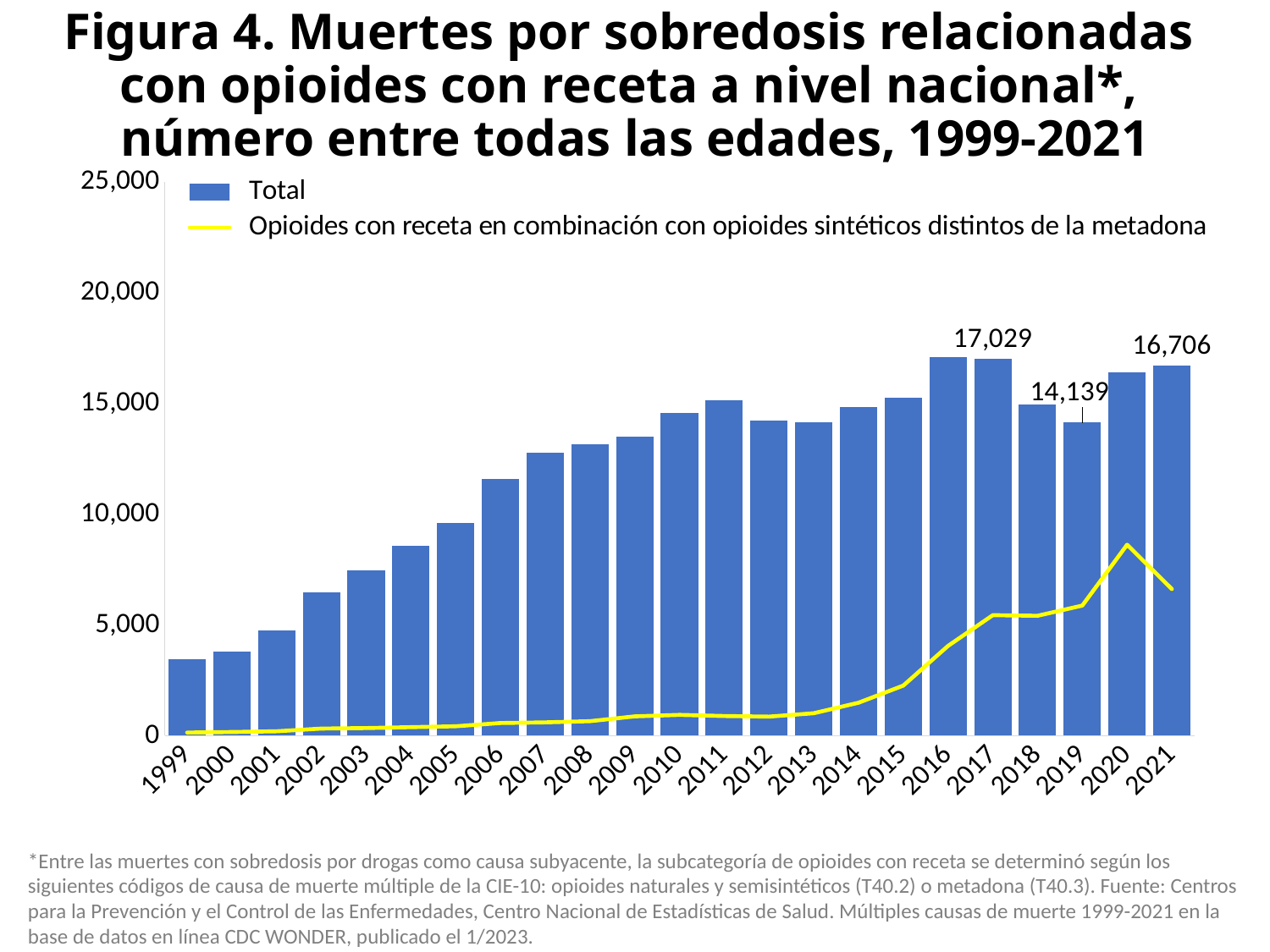
Is the value of the yellow line in 2015 greater or less than 5,000? less How many years are shown on the x axis? 23 Which is larger, the Total value for 2016 or for 2021? 2016 Is the Total value for 2010 greater or less than 10,000? greater How many series does the legend list? 2 Which year has the lowest Total bar? 1999 What is the value of the Total bar for 2021? 16,706 Is the Total value for 2005 greater or less than 10,000? less Does the Total series generally rise or fall from 1999 to 2016? rise In which year does the yellow line (opioides con receta en combinación con opioides sintéticos distintos de la metadona) reach its peak? 2020